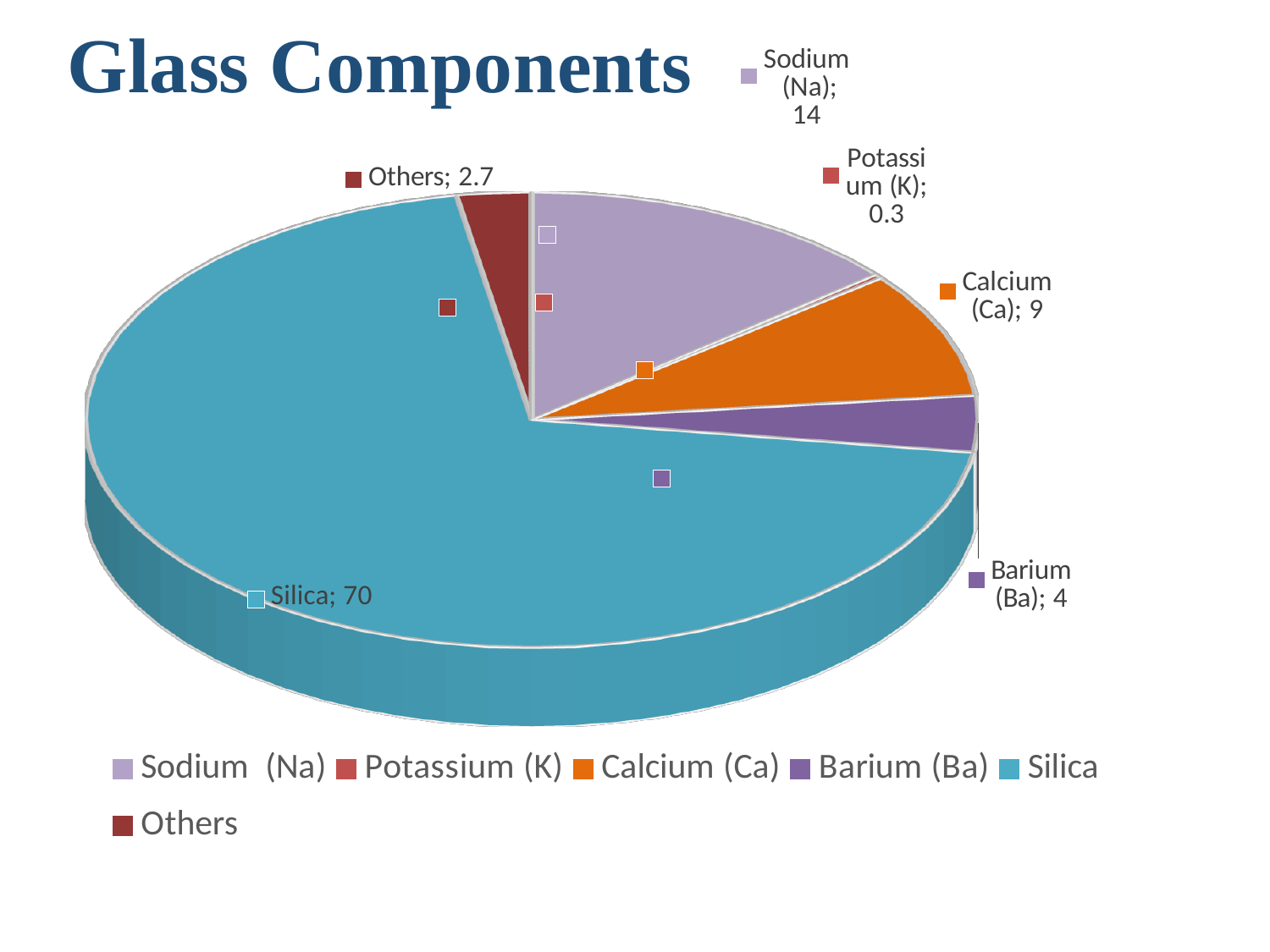
Which component has the largest slice? Silica What type of chart is shown on the slide? pie chart What is the value for Sodium (Na)? 14 What share of the pie does Silica represent? 70% What is the value for Silica? 70 What is the difference between the values for Calcium (Ca) and Barium (Ba)? 5 What is the value for Others? 2.7 Which component has the smallest slice? Potassium (K) What is the title of the chart? Glass Components How many slices does the pie chart have? 6 Which is larger, the value for Sodium (Na) or the value for Calcium (Ca)? Sodium (Na) What is the value for Potassium (K)? 0.3